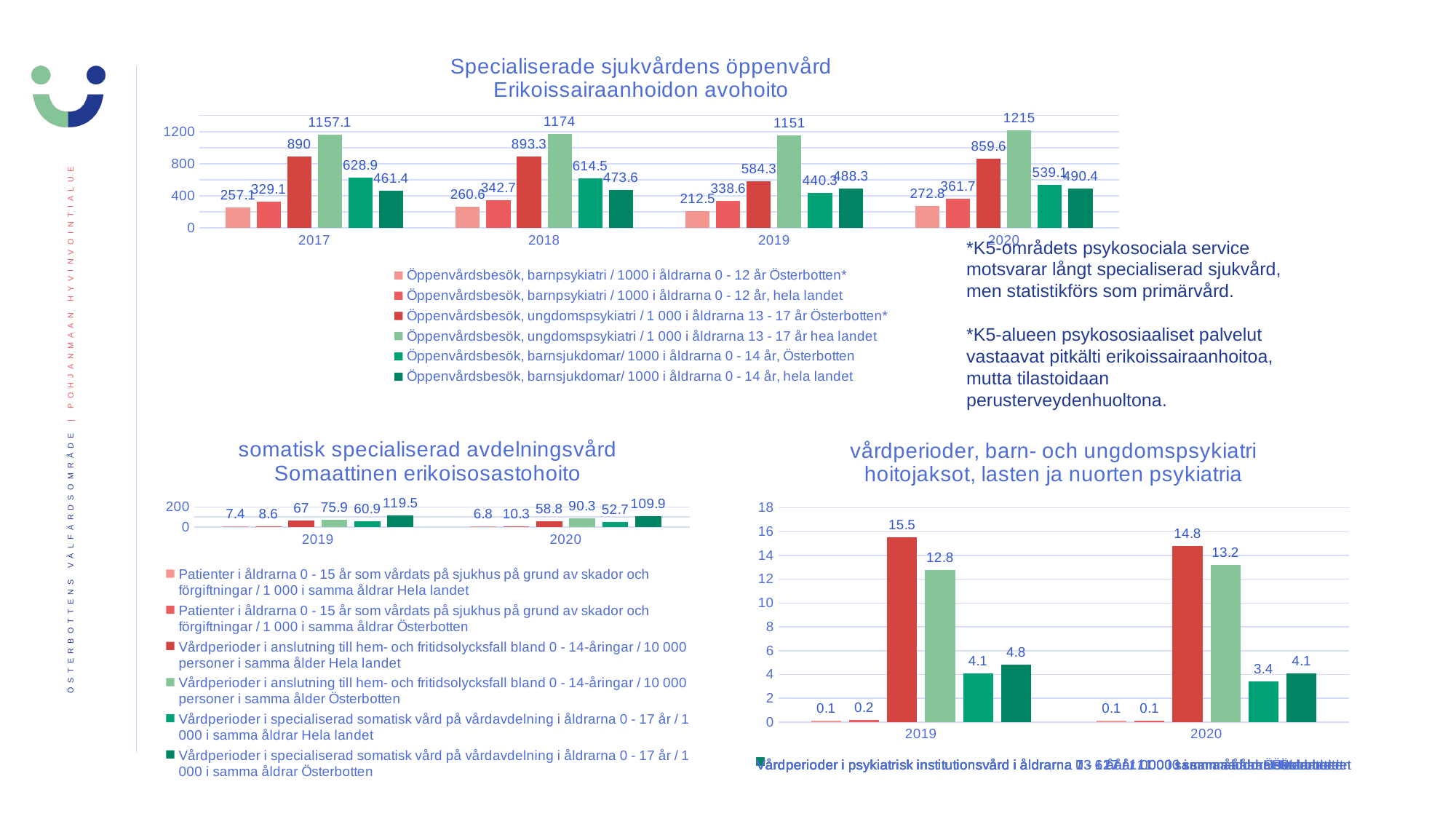
In the top chart 'Specialiserade sjukvårdens öppenvård', what is the difference between the 2018 values for 'Öppenvårdsbesök, barnsjukdomar/ 1000 i åldrarna 0 - 14 år, Österbotten' and 'Öppenvårdsbesök, barnsjukdomar/ 1000 i åldrarna 0 - 14 år, hela landet'? 140.9 How many series does the legend of the top chart 'Specialiserade sjukvårdens öppenvård' list? 6 In the bottom-right chart 'vårdperioder, barn- och ungdomspsykiatri', what is the value of the tallest bar in 2019? 15.5 In the bottom-left chart 'somatisk specialiserad avdelningsvård', what is the value for 'Vårdperioder i specialiserad somatisk vård på vårdavdelning i åldrarna 0 - 17 år / 1 000 i samma åldrar Österbotten' in 2019? 119.5 In the bottom-right chart 'vårdperioder, barn- och ungdomspsykiatri', what is the difference between the two dark green bars in 2020 (4.1) and 2019 (4.8)? 0.7 In the top chart 'Specialiserade sjukvårdens öppenvård', what is the value for 'Öppenvårdsbesök, barnpsykiatri / 1000 i åldrarna 0 - 12 år Österbotten*' in 2019? 212.5 In the bottom-right chart 'vårdperioder, barn- och ungdomspsykiatri', is the value of the light green bar in 2020 larger or smaller than the light green bar in 2019? Larger In the bottom-left chart 'somatisk specialiserad avdelningsvård', how many year categories are shown on the x axis? 2 What type of chart is the top chart 'Specialiserade sjukvårdens öppenvård'? Bar chart In the top chart 'Specialiserade sjukvårdens öppenvård', what is the value for 'Öppenvårdsbesök, ungdomspsykiatri / 1 000 i åldrarna 13 - 17 år hea landet' in 2020? 1215 In the top chart 'Specialiserade sjukvårdens öppenvård', in which year is the value for 'Öppenvårdsbesök, ungdomspsykiatri / 1 000 i åldrarna 13 - 17 år Österbotten*' lowest? 2019 In the bottom-left chart 'somatisk specialiserad avdelningsvård', which series has the highest value in 2020? Vårdperioder i specialiserad somatisk vård på vårdavdelning i åldrarna 0 - 17 år / 1 000 i samma åldrar Österbotten